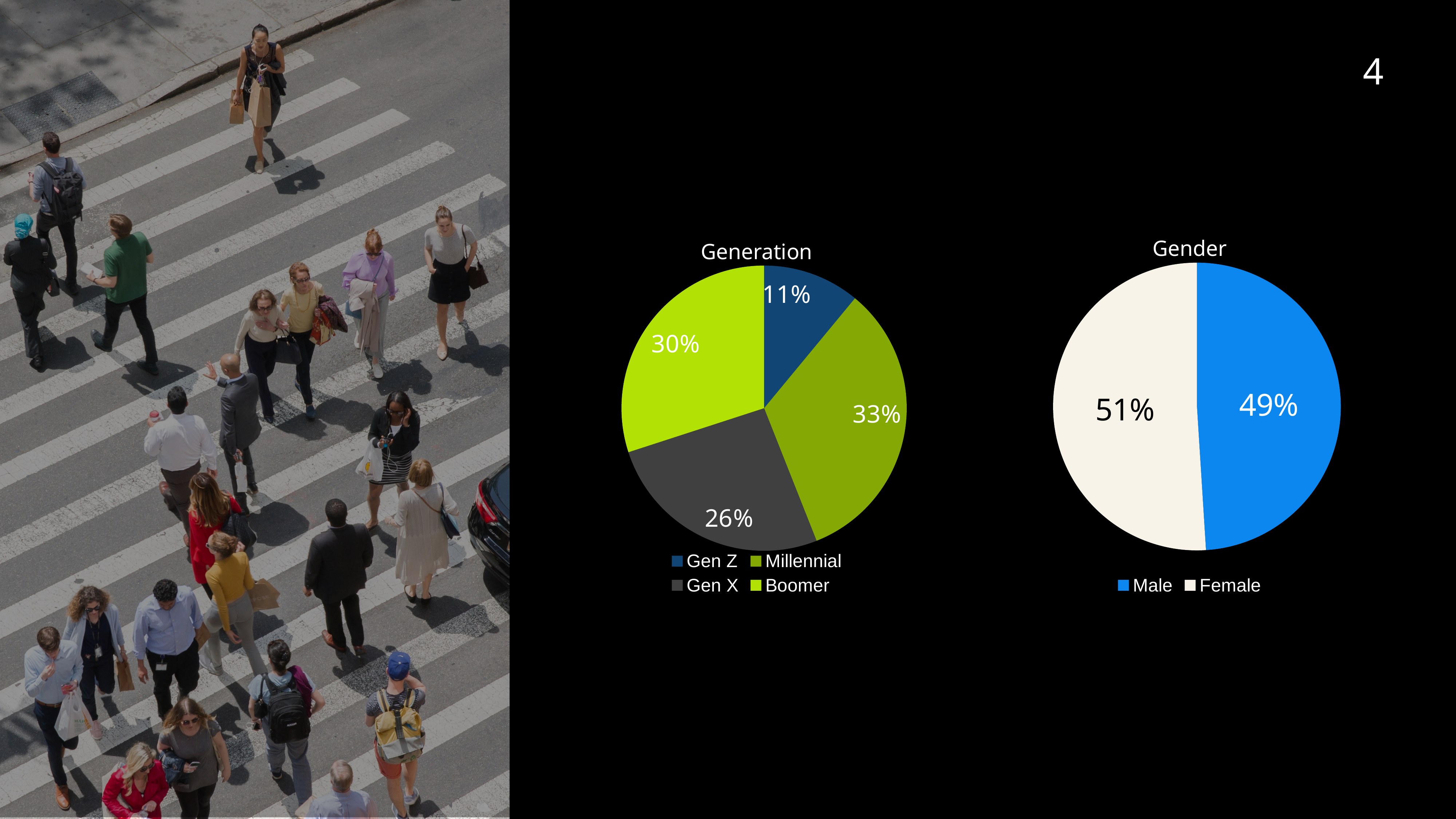
In the Generation chart, what share is Millennial? 33% In the Generation chart, which generation has the smallest share? Gen Z In the Generation chart, which is larger, Boomer or Gen X? Boomer In the Generation chart, what share is Gen Z? 11% In the Generation chart, what share is Gen X? 26% In the Generation chart, what is the difference between the Millennial and Gen Z shares? 22% What kind of chart is the Gender chart? Pie chart In the Gender chart, what share is Female? 51% In the Gender chart, what share is Male? 49% How many categories does the Generation chart show? 4 In the Generation chart, which generation has the largest share? Millennial In the Generation chart, what share is Boomer? 30%